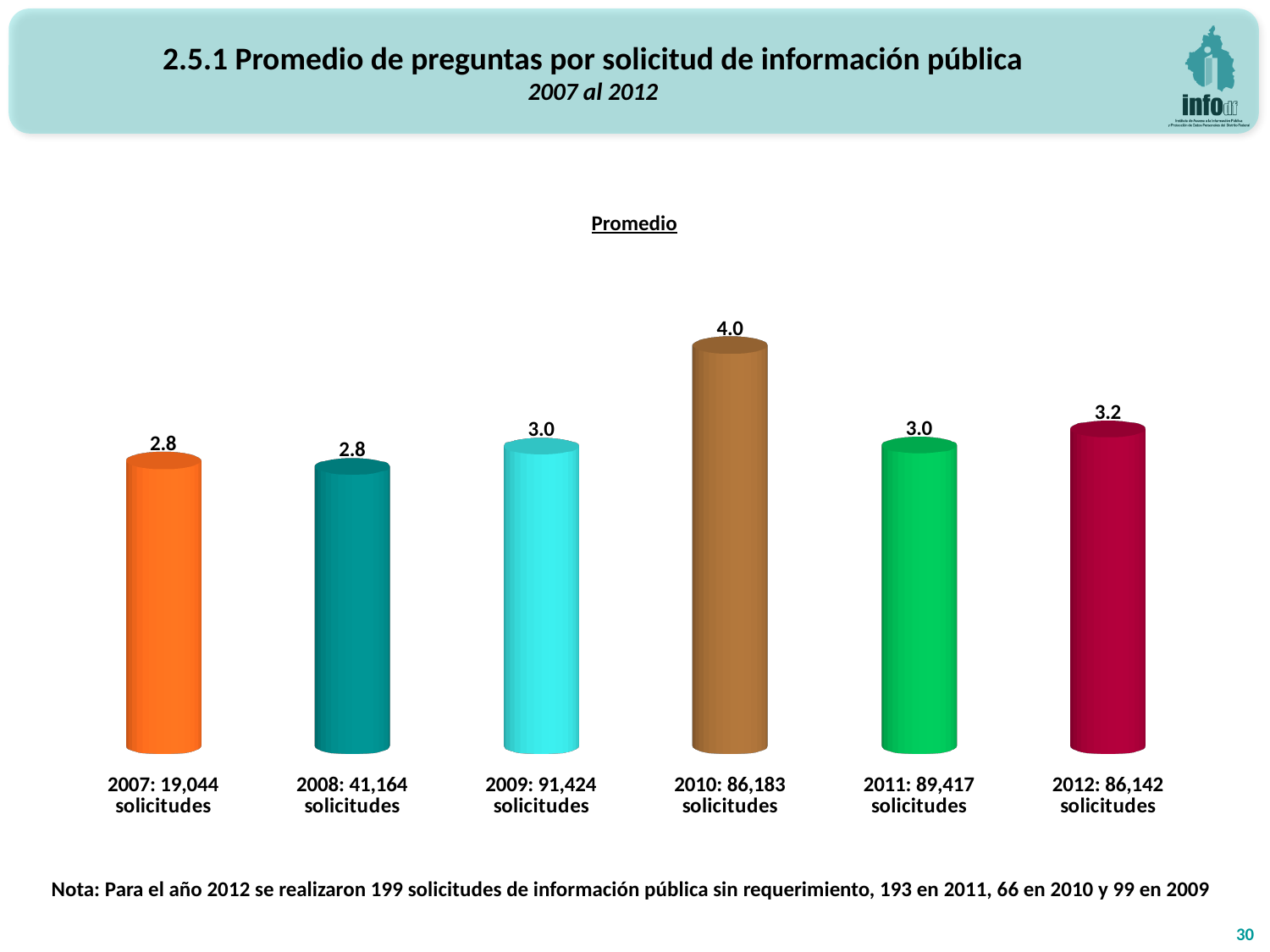
What is the difference between the promedio values for 2009 and 2008? 0.2 Do the promedio values rise or fall from 2010 to 2011? Fall How many solicitudes are listed in the category label for 2009? 91,424 Which year has the highest promedio value? 2010 How many years (bars) are shown in the chart? 6 Which is larger, the promedio value for 2011 or for 2012? 2012 What kind of chart is shown on the slide? Bar chart What is the promedio value shown for 2012? 3.2 What is the title shown above the chart? Promedio What is the average number of questions per request (promedio) shown for 2010? 4.0 What is the difference between the promedio values for 2010 and 2012? 0.8 What is the promedio value shown for 2007? 2.8